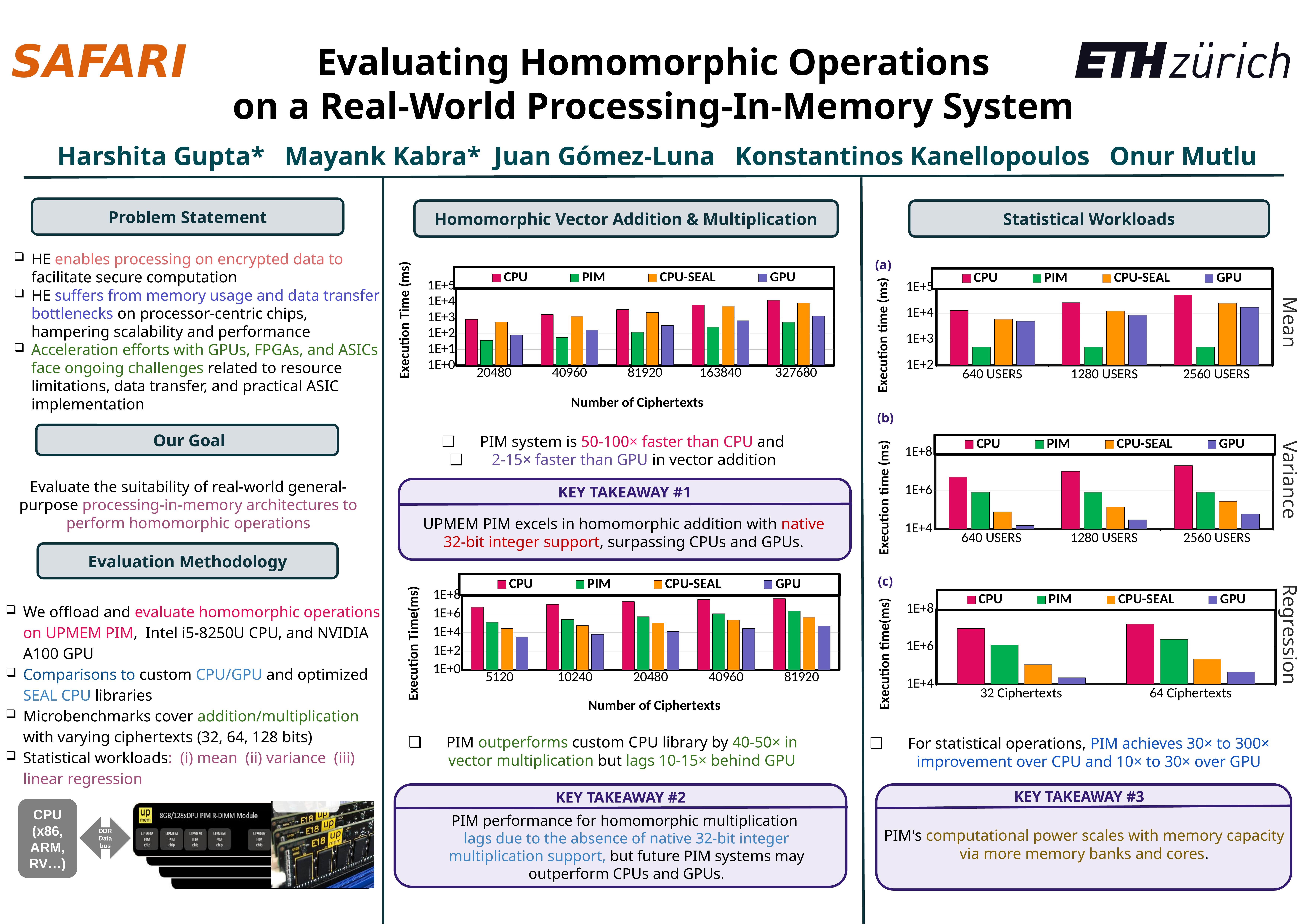
In the Mean chart (a) under 'Statistical Workloads', which series has the lowest execution time at 640 USERS? PIM In the Regression chart (c) under 'Statistical Workloads', which series has the highest execution time at 64 Ciphertexts? CPU In the Mean chart (a) under 'Statistical Workloads', is the CPU execution time at 2560 USERS greater or less than 1E+4? greater In the bottom chart under 'Homomorphic Vector Addition & Multiplication', which series has the lowest execution time at 5120 ciphertexts? GPU In the Variance chart (b) under 'Statistical Workloads', is the CPU-SEAL execution time at 640 USERS greater or less than 1E+6? less In the Regression chart (c) under 'Statistical Workloads', how many categories are shown on the x axis? 2 In the bottom chart under 'Homomorphic Vector Addition & Multiplication', which is larger at 81920 ciphertexts, CPU or GPU? CPU In the top chart under 'Homomorphic Vector Addition & Multiplication', how many series does the legend list? 4 In the top chart under 'Homomorphic Vector Addition & Multiplication', which series has the lowest execution time at 20480 ciphertexts? PIM In the top chart under 'Homomorphic Vector Addition & Multiplication', how many Number of Ciphertexts categories are shown on the x axis? 5 What kind of chart is the top chart under 'Homomorphic Vector Addition & Multiplication'? bar chart In the top chart under 'Homomorphic Vector Addition & Multiplication', does the CPU execution time rise or fall as the number of ciphertexts increases? rise